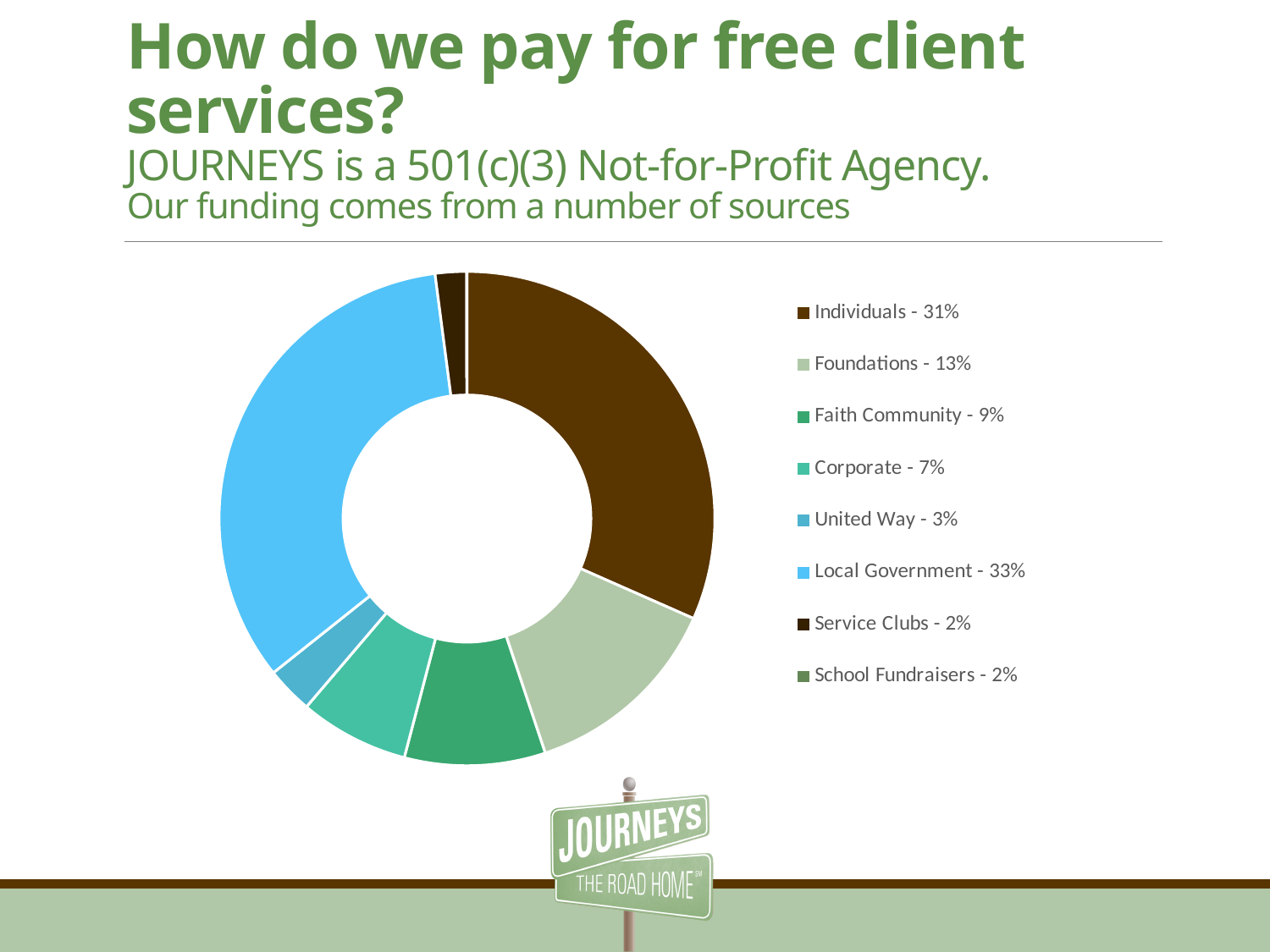
Which is larger, the share from Foundations or the share from Faith Community? Foundations What percentage of funding comes from Foundations? 13% What share of the chart does Local Government represent? 33% What is the combined share of Service Clubs and School Fundraisers? 4% What percentage of funding comes from United Way? 3% What colour is the Local Government slice? Light blue What percentage of funding comes from Corporate sources? 7% What is the difference in percentage points between Local Government and Individuals? 2 percentage points Which funding source accounts for the largest share? Local Government What percentage of funding comes from Individuals? 31% How many funding sources are shown in the chart? 8 What kind of chart is shown on the slide? Doughnut (pie) chart